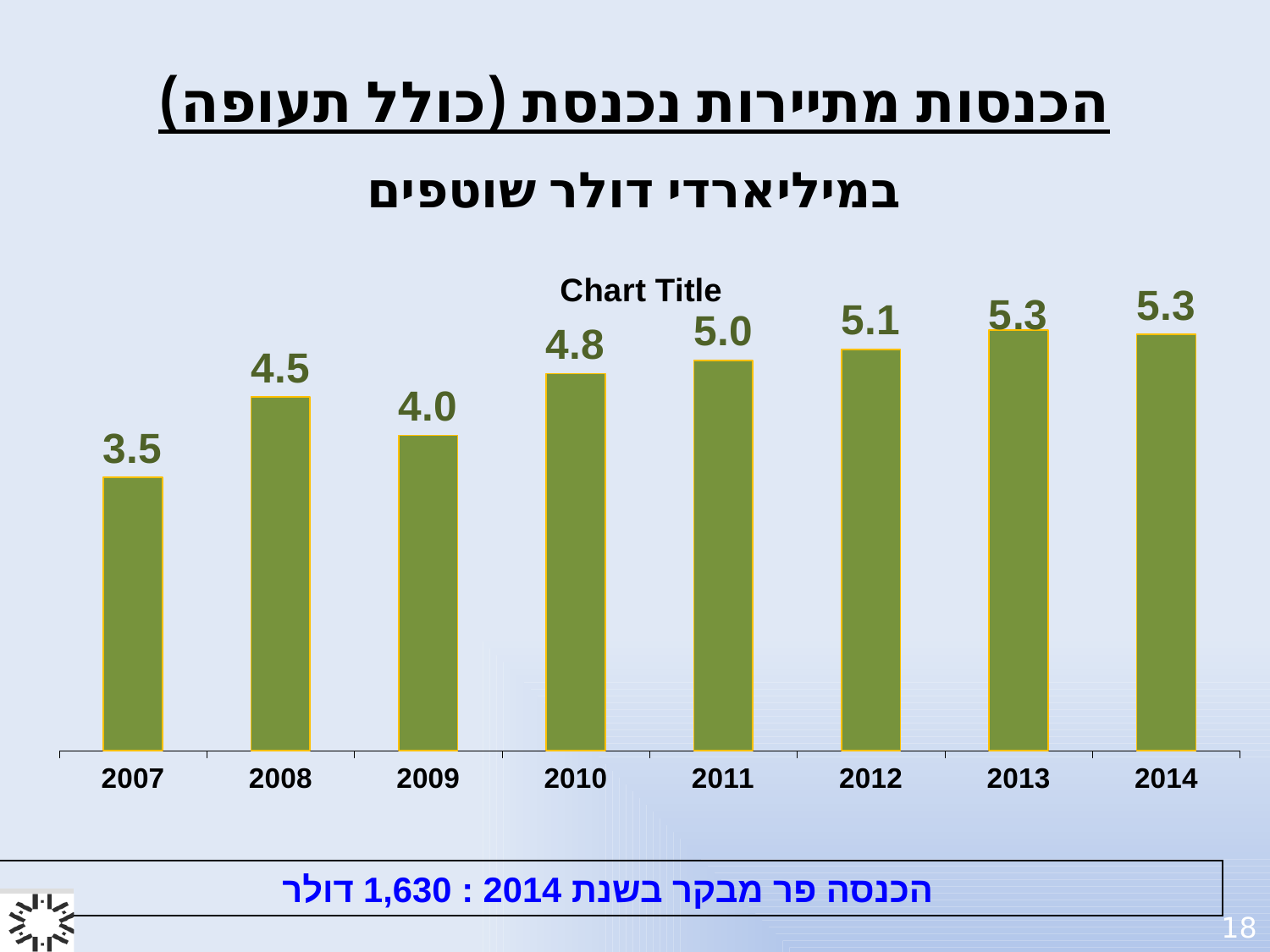
How many years are shown on the x axis? 8 Which year has the lowest value? 2007 What is the title printed above the chart? Chart Title Do the values generally rise or fall from 2009 to 2014? rise Which is larger, the value for 2011 or the value for 2012? 2012 What is the value for 2007? 3.5 What is the value for 2012? 5.1 What is the value for 2010? 4.8 What is the difference between the values for 2008 and 2009? 0.5 What kind of chart is shown on the slide? bar chart Which is larger, the value for 2008 or the value for 2009? 2008 What is the difference between the values for 2014 and 2007? 1.8